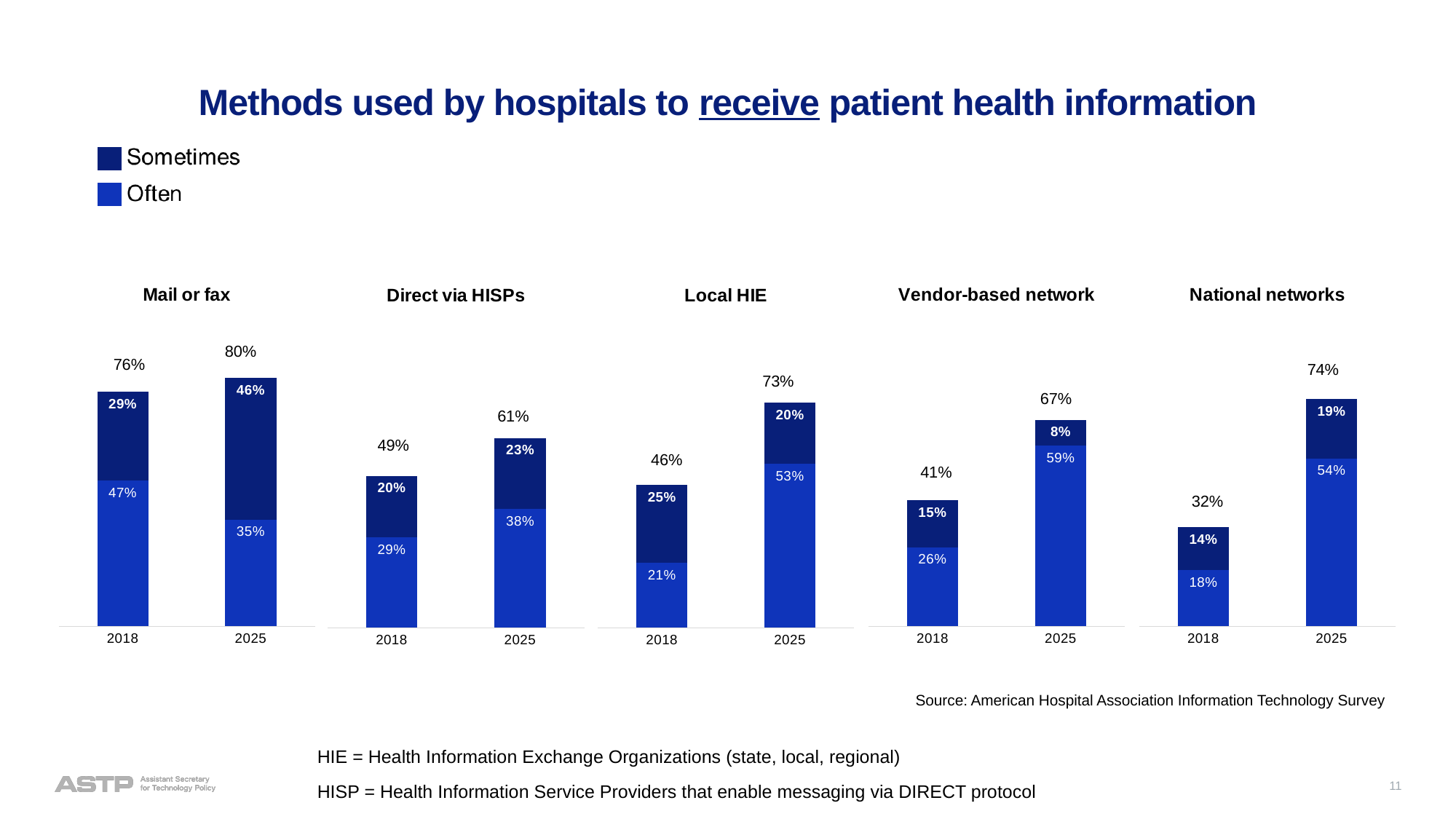
In the Mail or fax chart, what is the difference between the Sometimes values for 2025 and 2018? 17% What kind of chart is used for Direct via HISPs? Stacked bar chart In the National networks chart, what is the difference between the 2025 total and the 2018 total? 42% In the Vendor-based network chart, what is the total for the 2018 stacked bar? 41% How many series does the legend list? 2 In the National networks chart, does the total rise or fall from 2018 to 2025? Rise In the Mail or fax chart, what is the Often value for 2025? 35% In the Local HIE chart, which year has the larger Often value, 2018 or 2025? 2025 In the Vendor-based network chart, what is the Often value for 2025? 59% In the Local HIE chart, what is the total for the 2025 stacked bar? 73% Which colour represents the Often series in the legend? Lighter blue In the Direct via HISPs chart, what is the Sometimes value for 2018? 20%